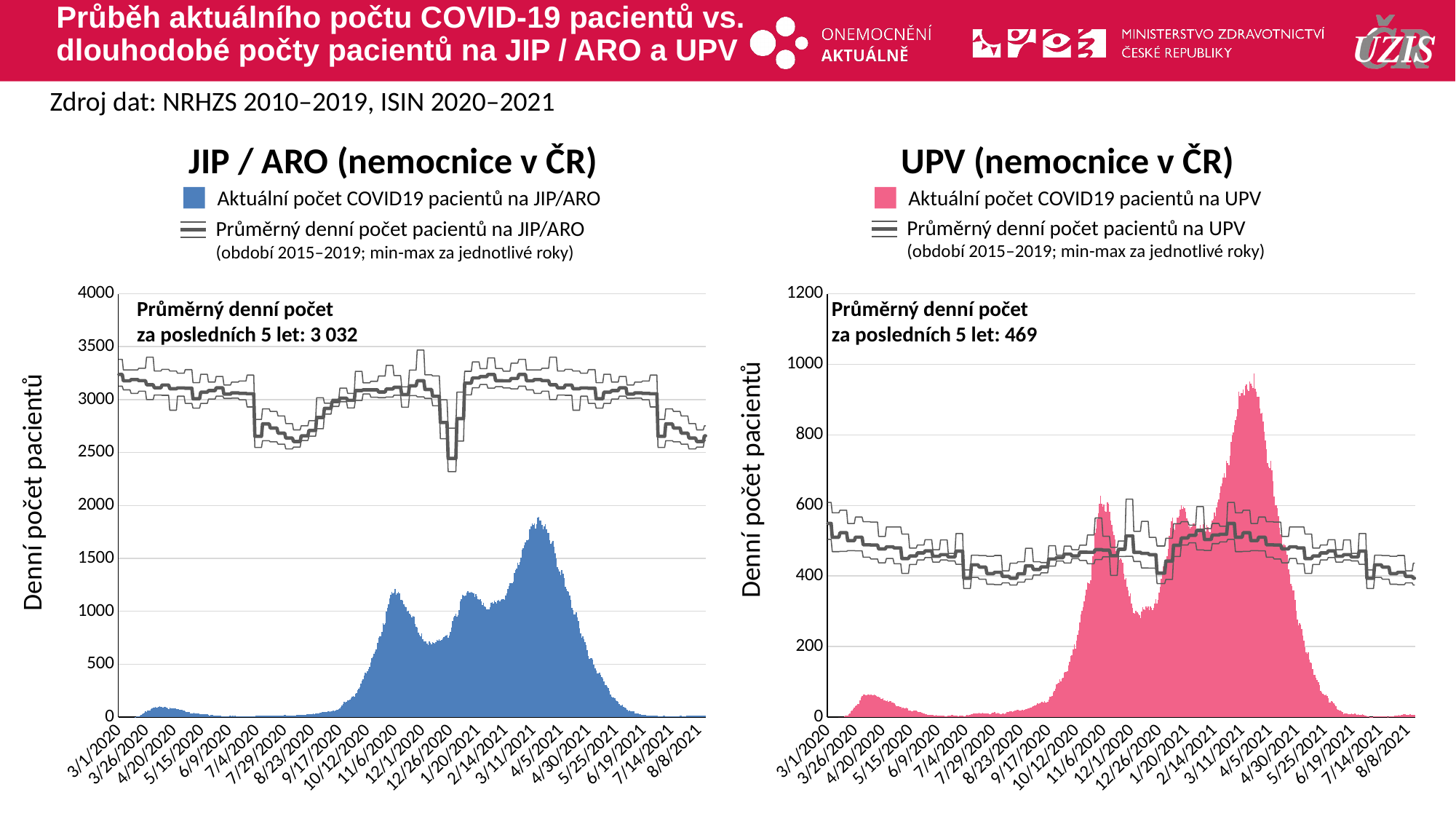
On the UPV (nemocnice v ČR) chart, is the peak number of COVID19 patients around 3/11/2021 greater or less than 1000? less On the UPV (nemocnice v ČR) chart, does the number of COVID19 patients rise or fall between 3/11/2021 and 6/19/2021? fall On the JIP / ARO (nemocnice v ČR) chart, is the number of COVID19 patients on 7/4/2020 greater or less than 500? less On the JIP / ARO (nemocnice v ČR) chart, what is the average daily number of patients over the last 5 years stated in the annotation? 3 032 On the JIP / ARO (nemocnice v ČR) chart, is the peak number of COVID19 patients around 3/11/2021 greater or less than 1500? greater On the UPV (nemocnice v ČR) chart, what is the average daily number of patients over the last 5 years stated in the annotation? 469 What is the difference between the 5-year average daily counts shown on the JIP / ARO chart (3 032) and the UPV chart (469)? 2 563 Which chart shows the higher 5-year average daily patient count, JIP / ARO or UPV? JIP / ARO What colour is used for the actual number of COVID19 patients on the UPV (nemocnice v ČR) chart? pink What is the y-axis label on the UPV (nemocnice v ČR) chart? Denní počet pacientů How many series does the legend of the UPV (nemocnice v ČR) chart list? 2 What kind of chart is the JIP / ARO (nemocnice v ČR) chart? area chart